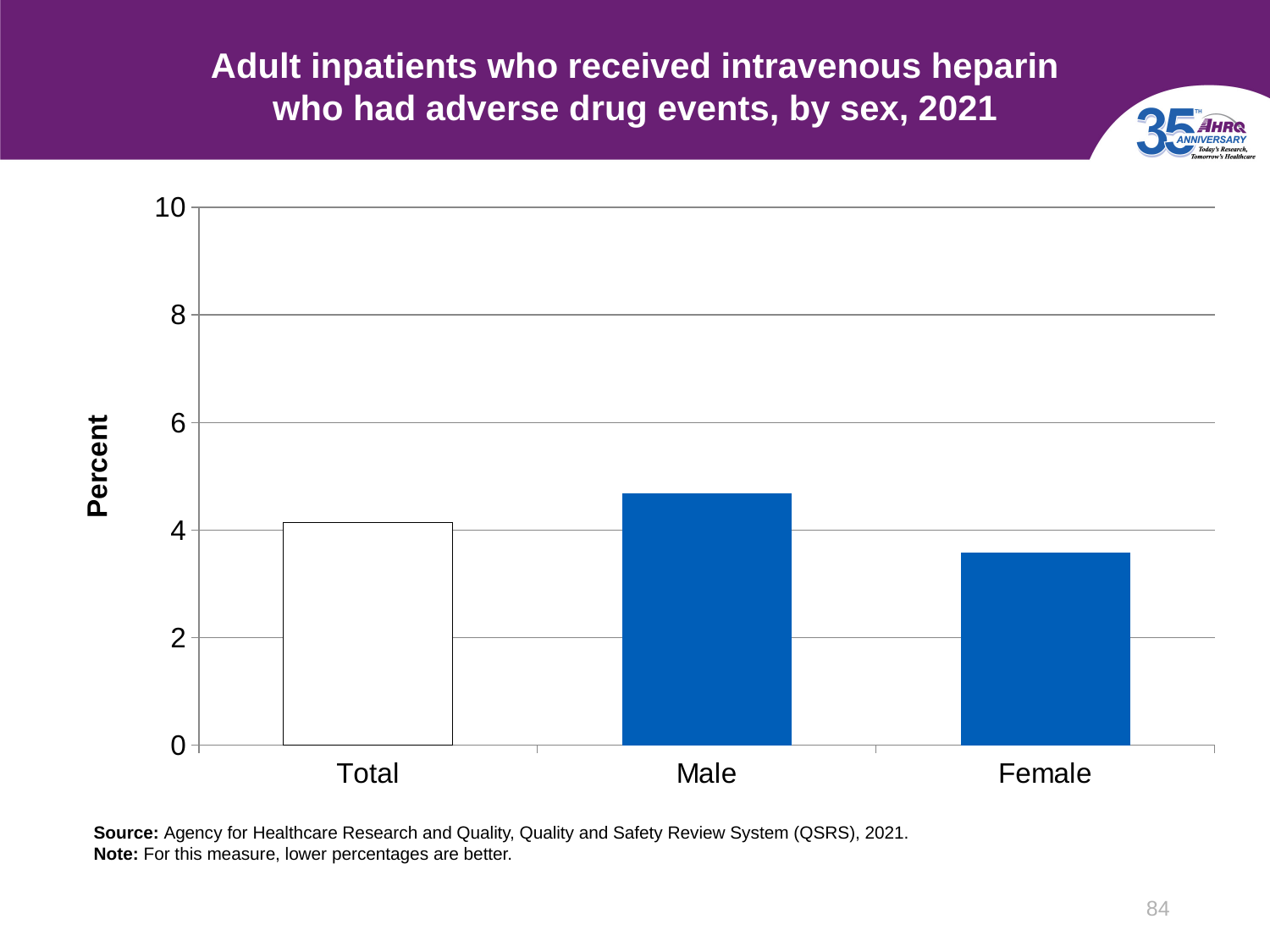
Is the value for Male greater or less than 4? greater Which category has the lowest percentage? Female Is the value for Total greater or less than 6? less How many categories are shown on the x axis? 3 Which is larger, the value for Male or the value for Female? Male Is the value for Male greater or less than 6? less What is the title of the chart? Adult inpatients who received intravenous heparin who had adverse drug events, by sex, 2021 What is the label on the y axis? Percent What kind of chart is shown on the slide? bar chart Which category has the highest percentage? Male